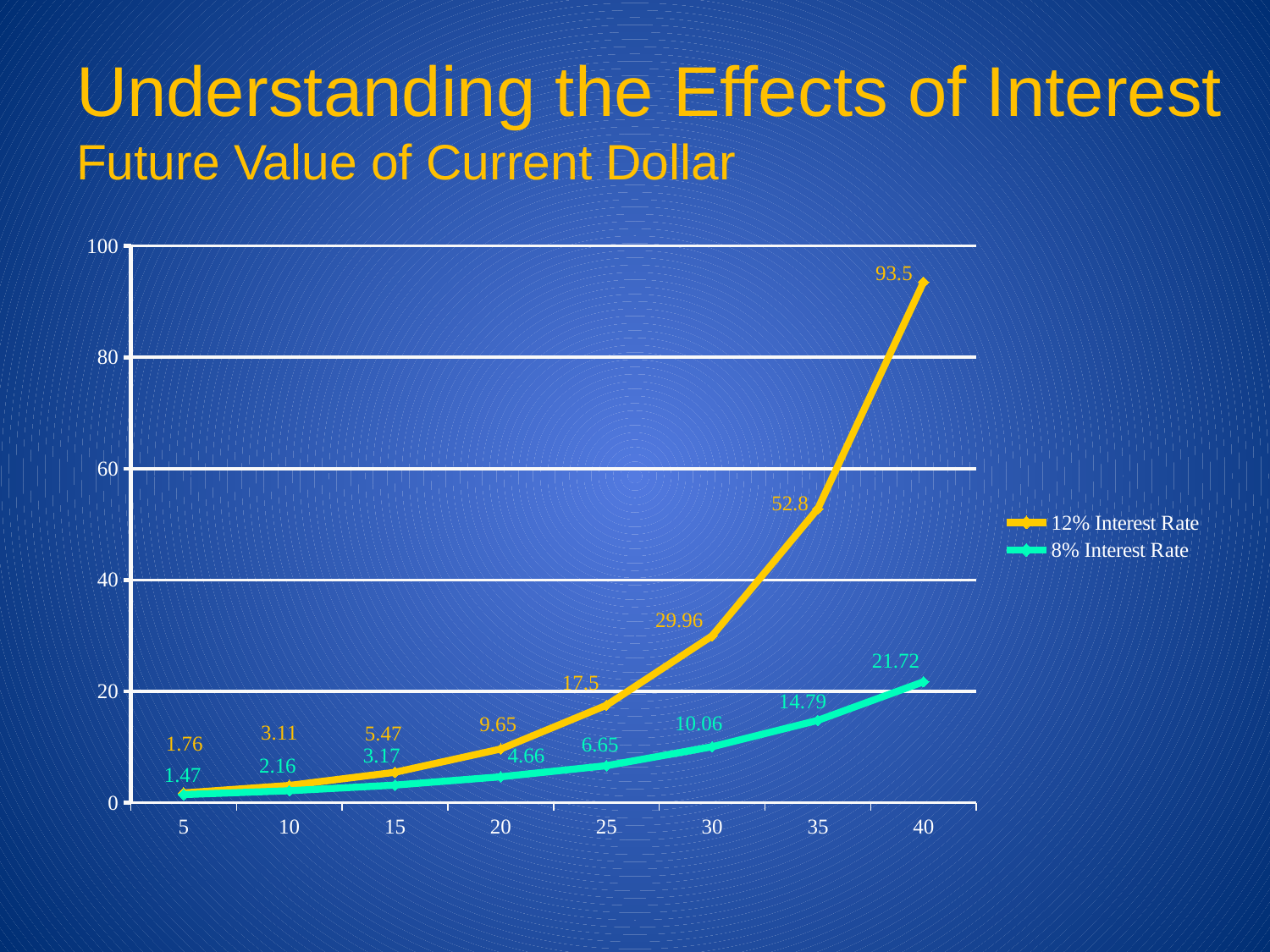
At which x-axis value does the 12% Interest Rate series reach its highest value? 40 How many series does the legend list? 2 What is the value of the 8% Interest Rate series at 25? 6.65 What kind of chart is shown on the slide? Line chart What is the value of the 12% Interest Rate series at 40? 93.5 At which x-axis value is the 8% Interest Rate series lowest? 5 Which series has the larger value at 20, 12% Interest Rate or 8% Interest Rate? 12% Interest Rate What is the value of the 8% Interest Rate series at 40? 21.72 What is the difference between the 12% Interest Rate and 8% Interest Rate values at 35? 38.01 What is the value of the 12% Interest Rate series at 30? 29.96 How many data points are plotted for each series? 8 Do the values of the 12% Interest Rate series rise or fall as the x-axis increases? Rise